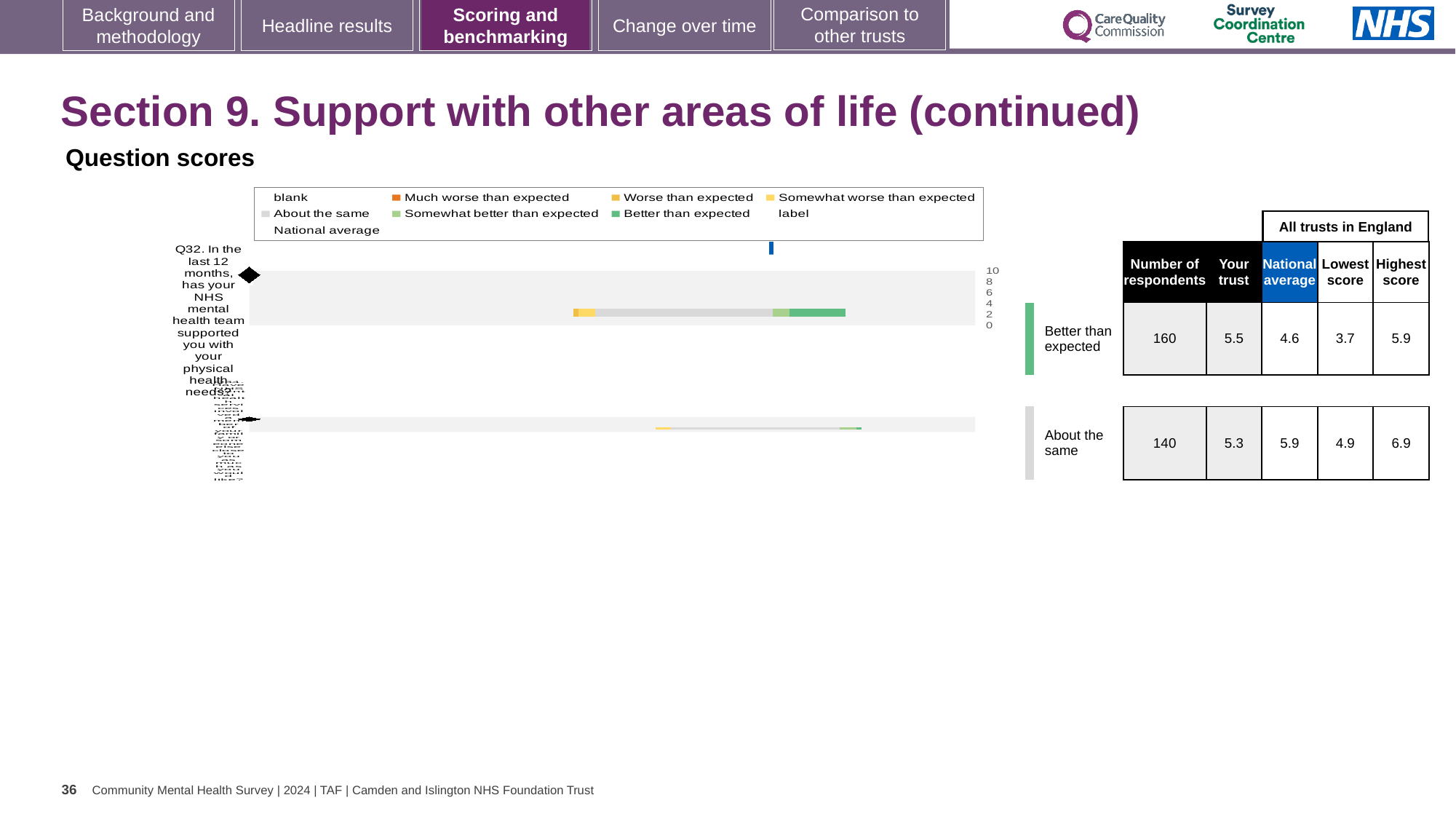
What colour represents 'Much worse than expected' in the chart legend? orange What is the national average score for Q32? 4.6 For Q32, which is larger: the trust's score or the national average? the trust's score What is the 'Your trust' score for Q32 (support with physical health needs)? 5.5 What is the highest score among all trusts in England for Q32? 5.9 How is the trust's result for Q32 categorised relative to expectations? Better than expected What is the lowest score among all trusts in England for Q32? 3.7 What is the difference between the trust's score and the national average for Q32? 0.9 What is the difference between the highest and lowest scores for Q32 across all trusts in England? 2.2 How many respondents answered Q32? 160 What is the heading above the chart? Question scores What kind of chart is shown on the slide? bar chart